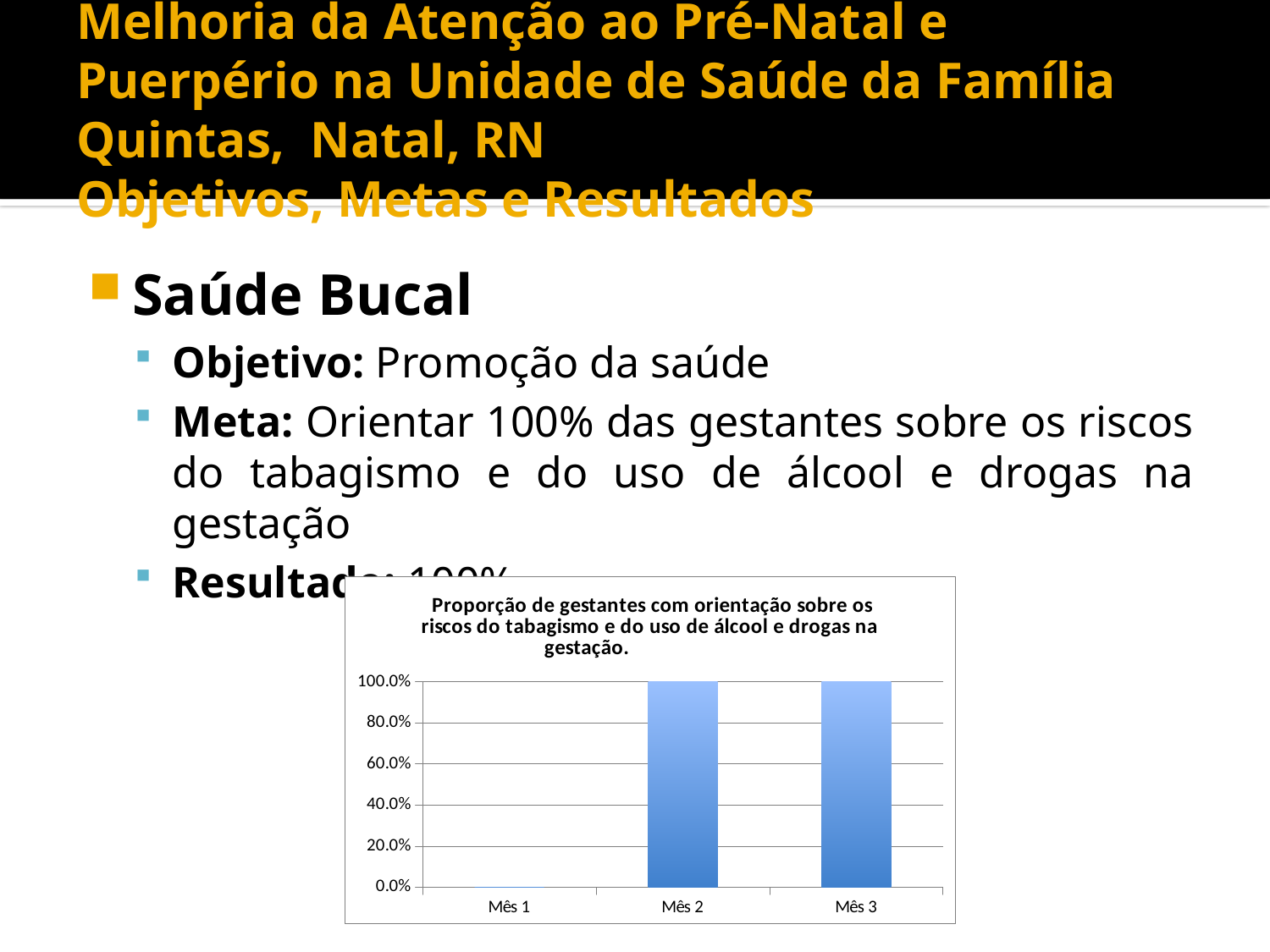
What is the highest tick value shown on the y axis of the chart? 100.0% Which is larger, the value for Mês 1 or the value for Mês 2? Mês 2 What is the value for Mês 2 in the chart? 100.0% Do the values rise or fall from Mês 1 to Mês 3? rise How many categories (months) are shown on the x axis of the chart? 3 Is the value for Mês 1 greater or less than 20.0%? less What kind of chart is shown on the slide? bar chart Which month has the lowest value in the chart? Mês 1 What is the title of the chart? Proporção de gestantes com orientação sobre os riscos do tabagismo e do uso de álcool e drogas na gestação. Is the value for Mês 3 greater or less than 80.0%? greater What is the difference between the values for Mês 2 and Mês 3? 0.0% What is the value for Mês 3 in the chart? 100.0%